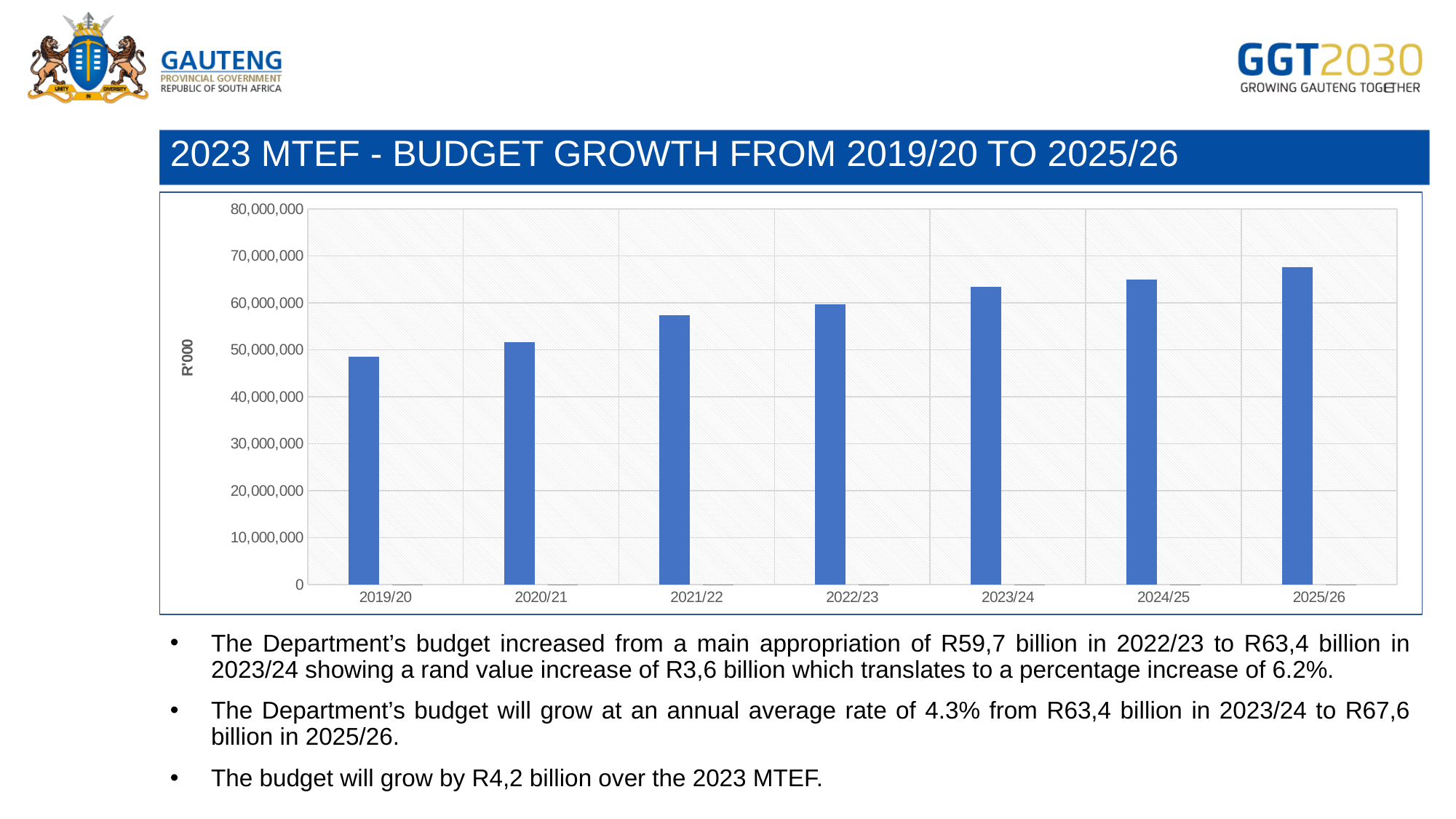
Which financial year has the lowest budget value on the chart? 2019/20 Is the value for 2021/22 greater or less than 60,000,000? less Which financial year has the highest budget value on the chart? 2025/26 What kind of chart is shown on the slide? bar chart Is the value for 2023/24 greater or less than 60,000,000? greater How many financial years are plotted on the chart? 7 What is the label on the vertical axis of the chart? R'000 Which is larger, the value for 2024/25 or the value for 2020/21? 2024/25 What is the title shown above the chart? 2023 MTEF - BUDGET GROWTH FROM 2019/20 TO 2025/26 Is the value for 2019/20 greater or less than 50,000,000? less Do the budget values rise or fall from 2019/20 to 2025/26? rise